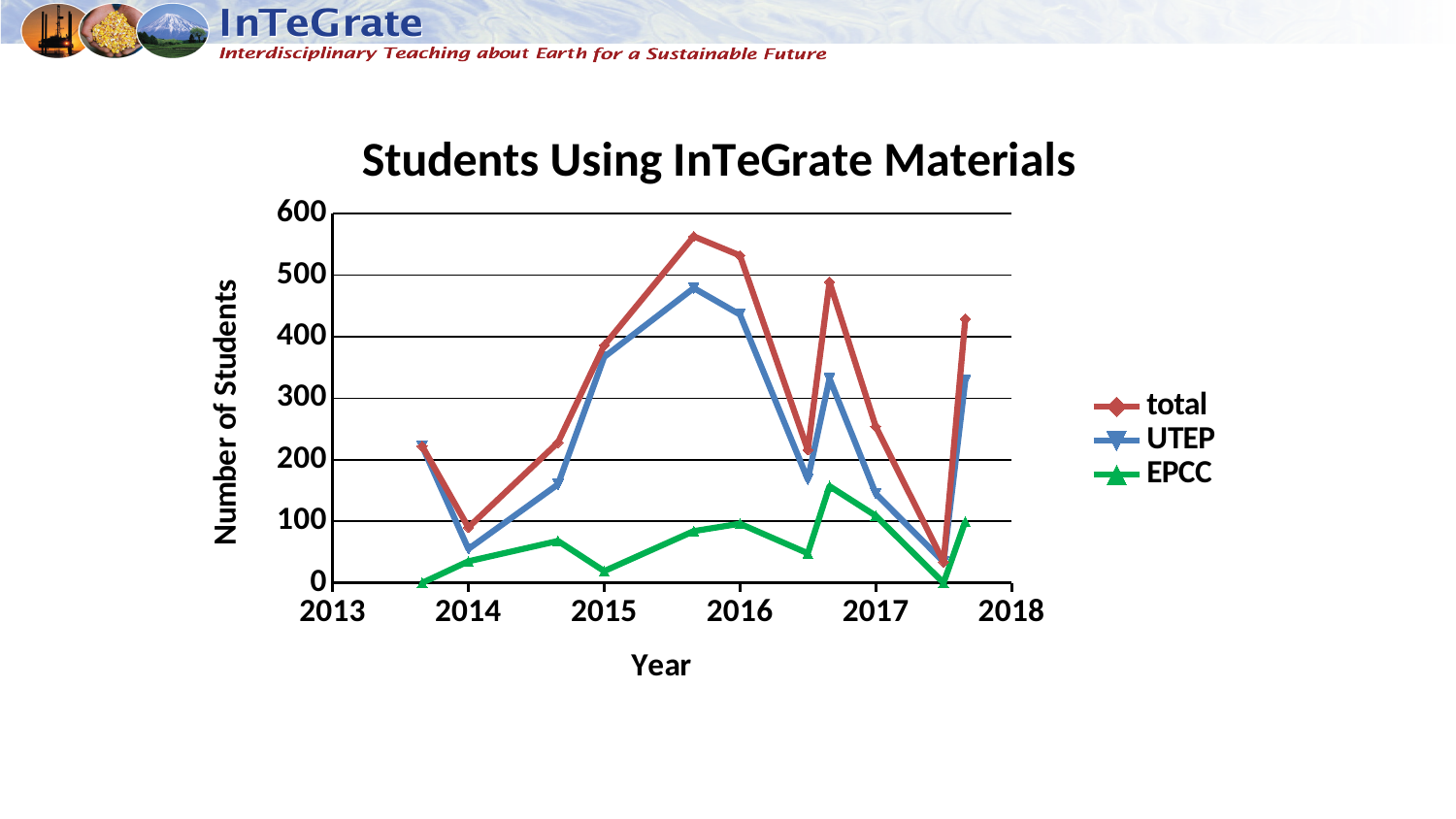
What kind of chart is shown on the slide? line chart At 2016, which is larger, the total series or the UTEP series? total Is the highest value for EPCC (between 2016 and 2017) greater or less than 100? greater Which series has the lowest values throughout the chart? EPCC How many series does the legend list? 3 Does the total series rise or fall between 2014 and its peak before 2016? rise Is the value for UTEP at 2014 greater or less than 100? less What is the title of the chart? Students Using InTeGrate Materials Is the peak value of the total series (between 2015 and 2016) greater or less than 500? greater What is the label of the vertical axis? Number of Students What is the value of the EPCC series at its first data point (late 2013)? 0 Which series reaches the highest value on the chart? total